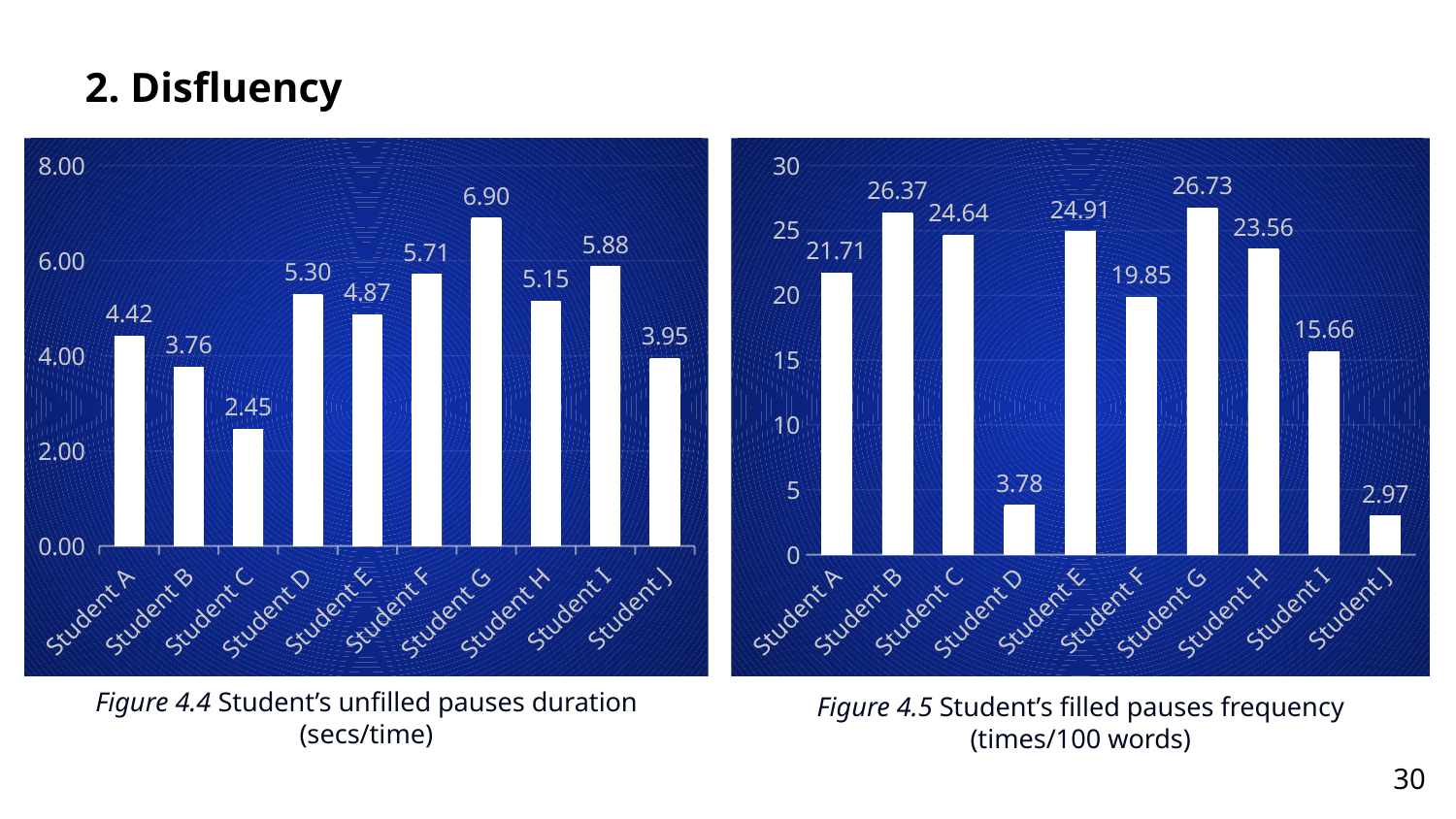
What unit is given in the caption of the Figure 4.5 chart (right)? times/100 words In the Figure 4.4 chart (left), which student has the lowest unfilled pauses duration? Student C What type of chart is the Figure 4.5 chart (right)? Bar chart In the Figure 4.5 chart (right), is the value for Student F greater or less than 20? less In the Figure 4.4 chart (left), what is the unfilled pauses duration for Student G? 6.90 In the Figure 4.5 chart (right), what is the difference between Student B's and Student I's values? 10.71 In the Figure 4.4 chart (left), what is the difference between Student G's and Student C's values? 4.45 In the Figure 4.5 chart (right), which student has the lowest filled pauses frequency? Student J In the Figure 4.4 chart (left), which is larger, the value for Student D or Student E? Student D How many students are shown in the Figure 4.4 chart (left)? 10 In the Figure 4.5 chart (right), which student has the highest filled pauses frequency? Student G In the Figure 4.5 chart (right), what is the filled pauses frequency for Student D? 3.78